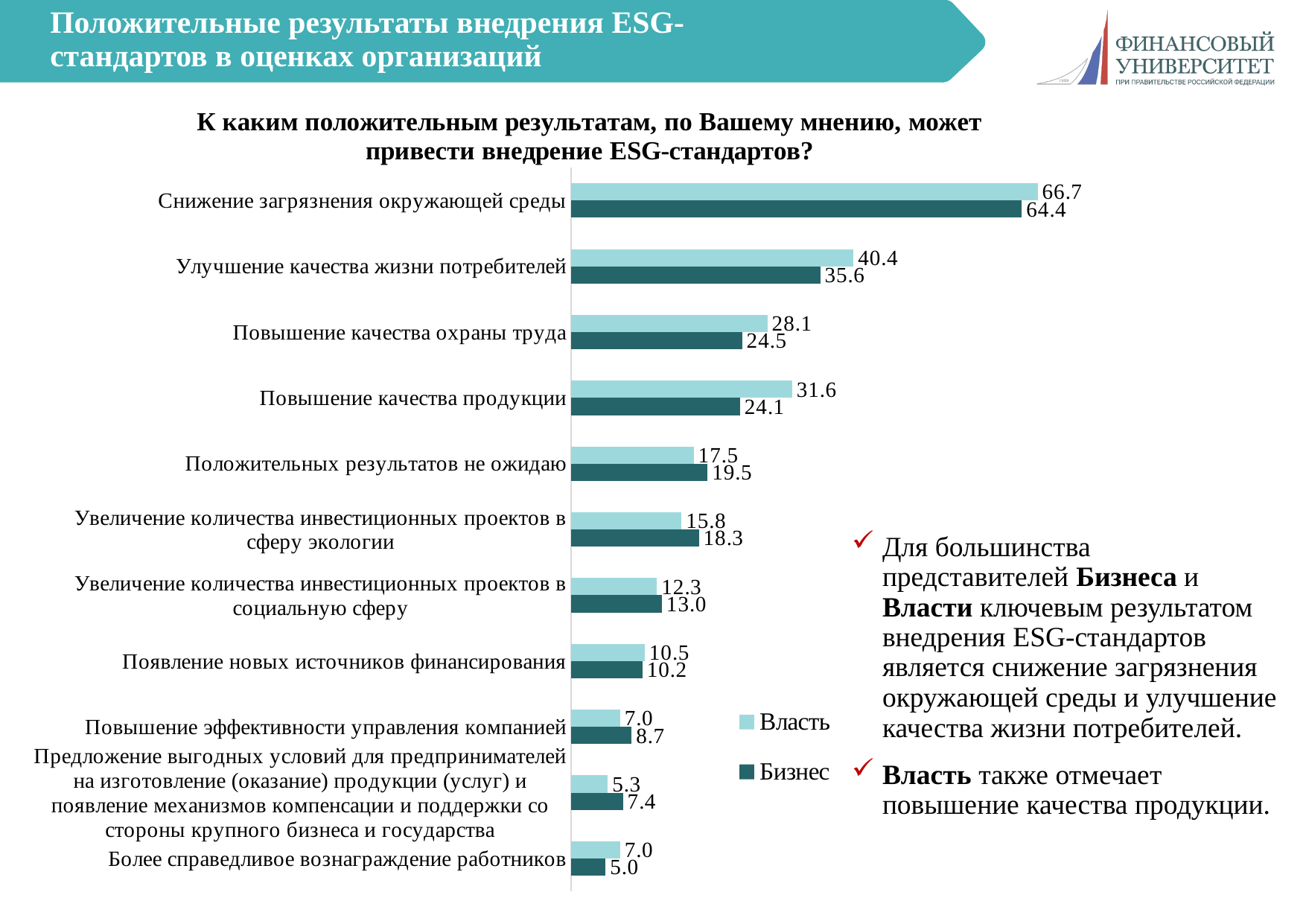
How many categories (response options) are shown in the chart? 11 What type of chart is shown on the slide? Bar chart What is the value for Бизнес for "Улучшение качества жизни потребителей"? 35.6 For "Увеличение количества инвестиционных проектов в сферу экологии", which series has the larger value, Власть or Бизнес? Бизнес What is the value for Власть for "Снижение загрязнения окружающей среды"? 66.7 What is the value for Бизнес for "Положительных результатов не ожидаю"? 19.5 How many series does the chart legend list? 2 Which category has the lowest value for Бизнес? Более справедливое вознаграждение работников Which series is shown in the darker teal colour in the chart? Бизнес What is the difference between the Власть values for "Улучшение качества жизни потребителей" and "Повышение качества охраны труда"? 12.3 What is the difference between the Власть and Бизнес values for "Повышение качества продукции"? 7.5 Which category has the highest value for Бизнес? Снижение загрязнения окружающей среды